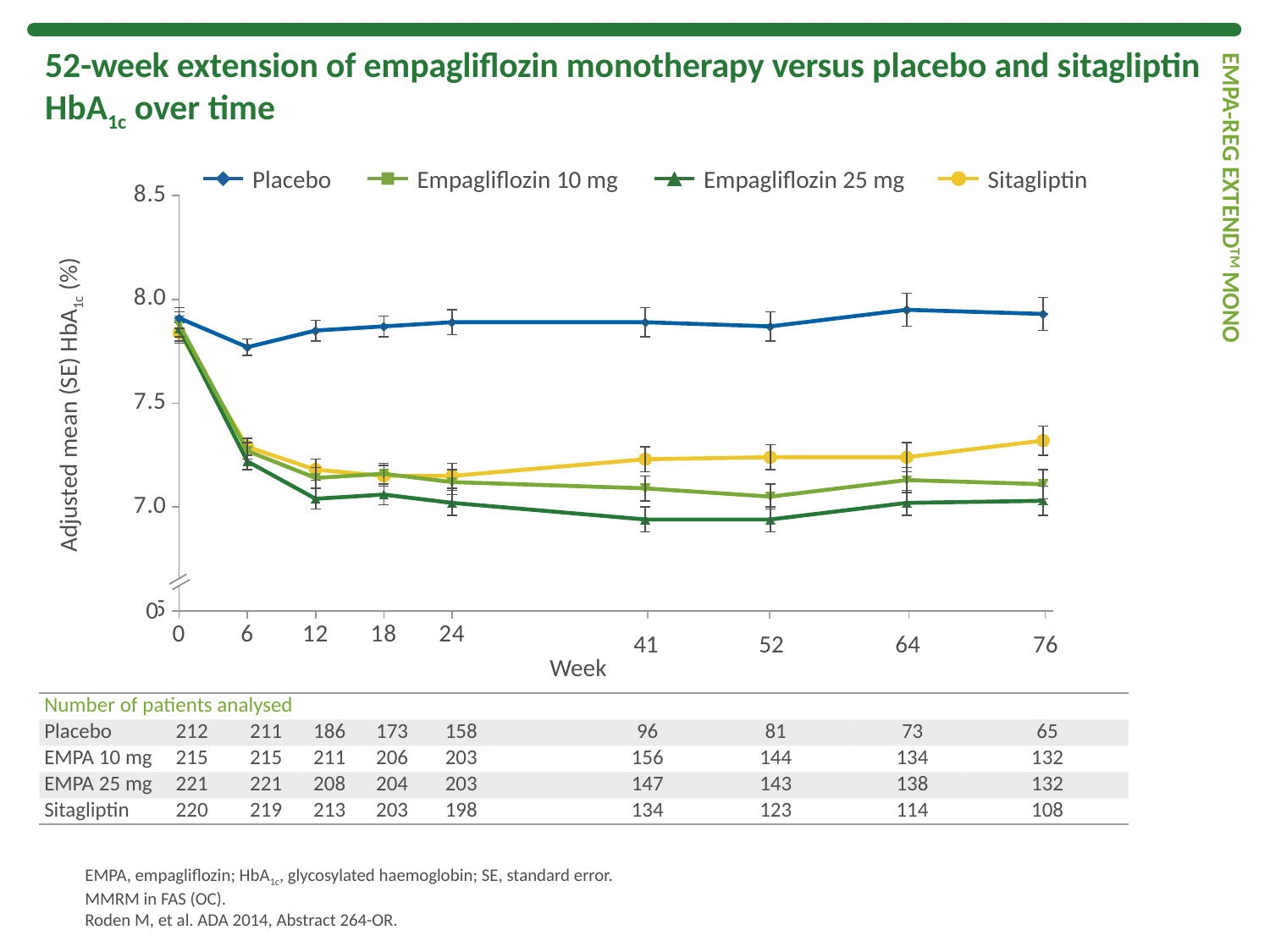
Which series has the lowest HbA1c value at week 76? Empagliflozin 25 mg Does the Empagliflozin 25 mg line rise or fall between week 0 and week 6? fall In the table below the chart, how many Placebo patients were analysed at week 76? 65 How many week time points are marked on the x axis? 9 What is the label on the y axis of the chart? Adjusted mean (SE) HbA1c (%) How many series does the legend list? 4 Is the value for Sitagliptin at week 76 greater or less than 7.0? greater Does the Sitagliptin line rise or fall between week 24 and week 76? rise Which series has the highest HbA1c value at week 76? Placebo Is the value for Placebo at week 76 greater or less than 7.5? greater At week 76, which is larger: the value for Sitagliptin or the value for Empagliflozin 10 mg? Sitagliptin What kind of chart is shown on the slide? Line chart